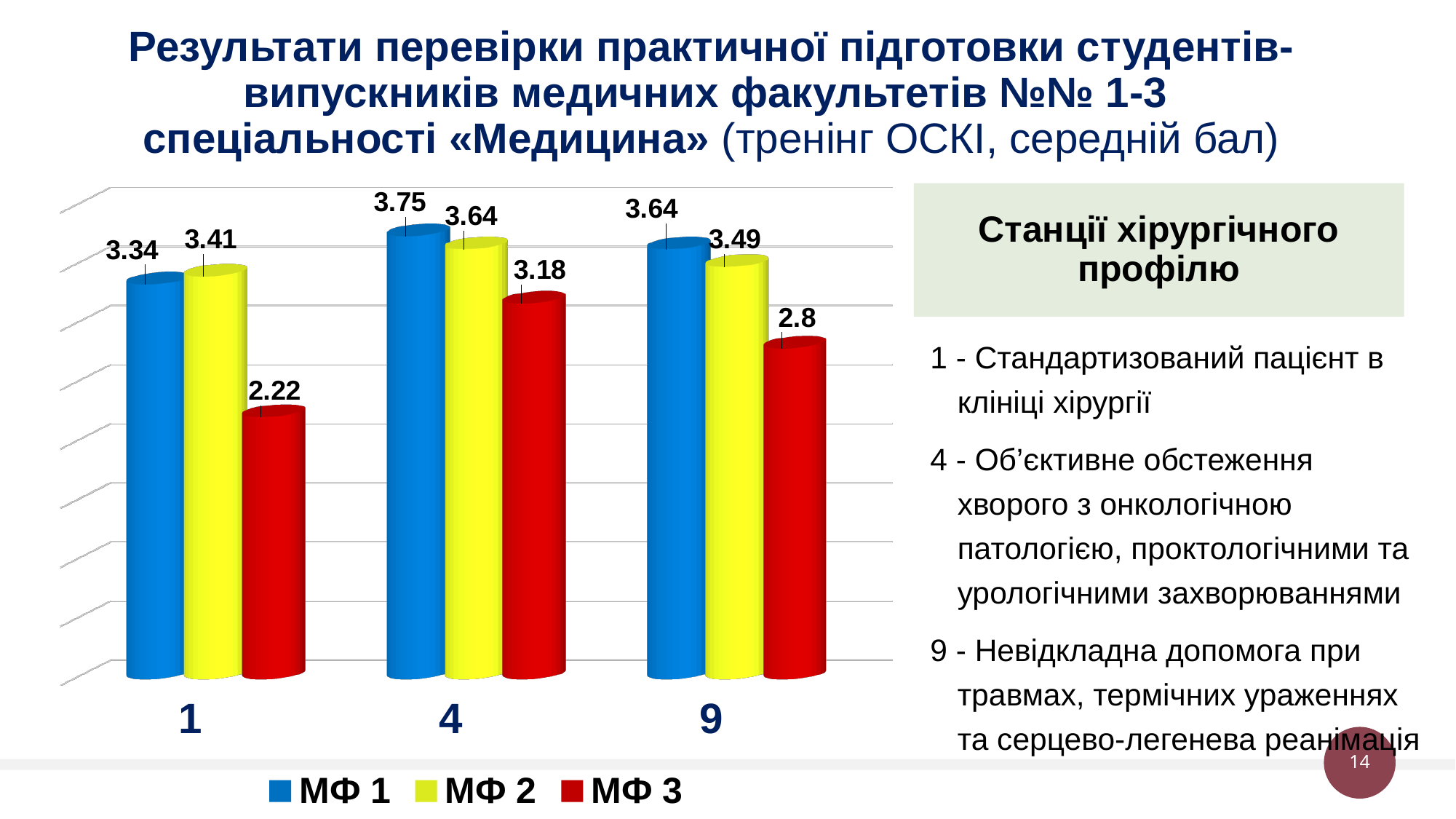
What is the value for МФ 3 at station 4? 3.18 Which station has the highest value for МФ 1? 4 What is the value for МФ 2 at station 9? 3.49 What is the value for МФ 1 at station 1? 3.34 Which station has the lowest value for МФ 3? 1 What is the difference between МФ 1 and МФ 3 at station 9? 0.84 How many stations (categories) are shown on the x axis? 3 Which colour represents МФ 3 in the chart? Red How many series does the legend list? 3 What is the value for МФ 3 at station 1? 2.22 What kind of chart is shown on the slide? Bar chart Which is larger at station 1: МФ 1 or МФ 2? МФ 2